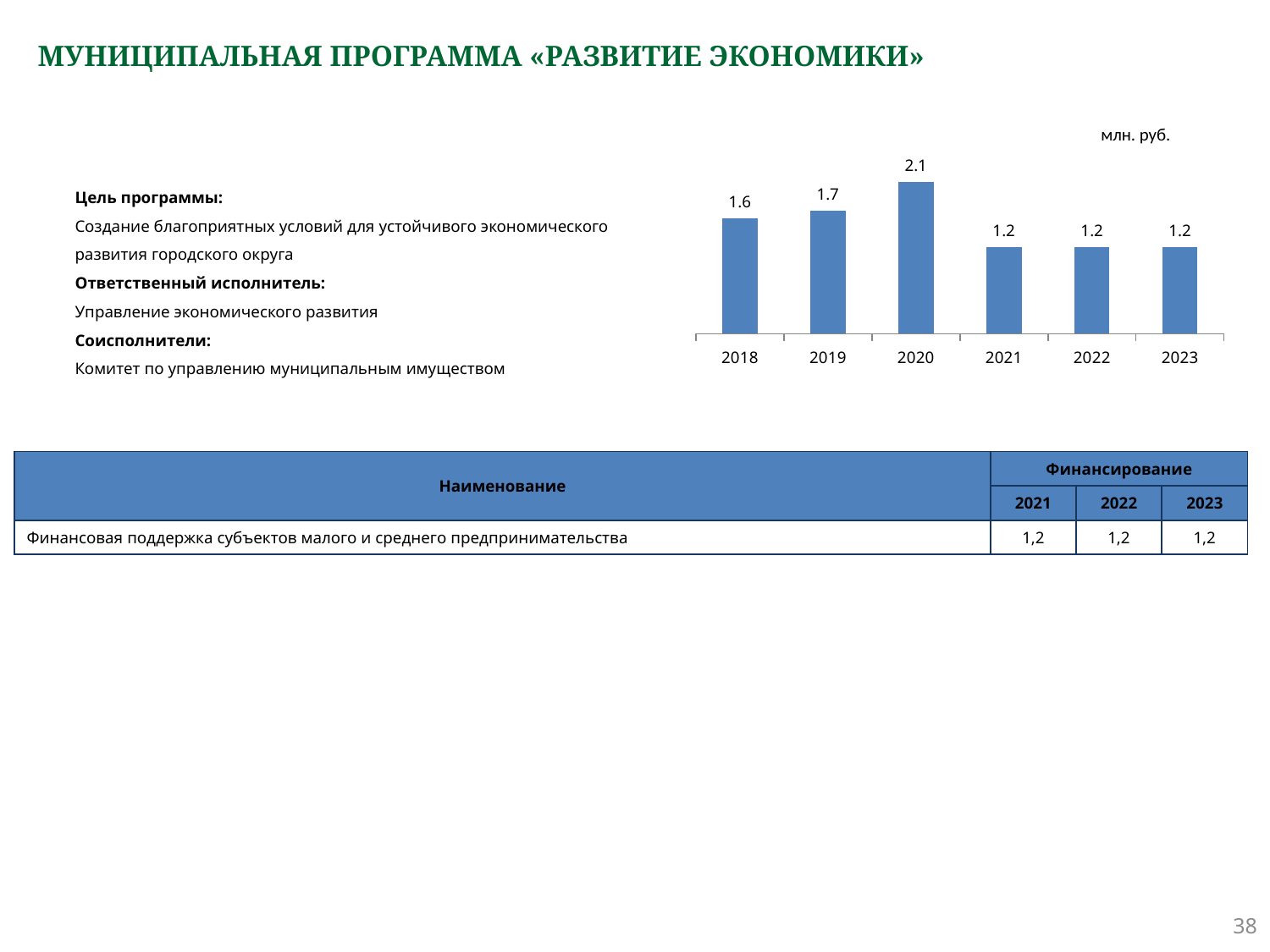
What is the difference between the values for 2019 and 2018? 0.1 What is the difference between the values for 2020 and 2021? 0.9 How many years are shown on the x axis of the chart? 6 Which is larger, the value for 2019 or the value for 2023? 2019 What is the value for 2018 in the chart? 1.6 What is the value for 2020 in the chart? 2.1 What unit is indicated above the chart? млн. руб. What colour are the bars in the chart? blue What is the value for 2022 in the chart? 1.2 Which year has the highest value in the chart? 2020 What kind of chart is shown on the slide? bar chart Do the values rise or fall from 2018 to 2020? rise